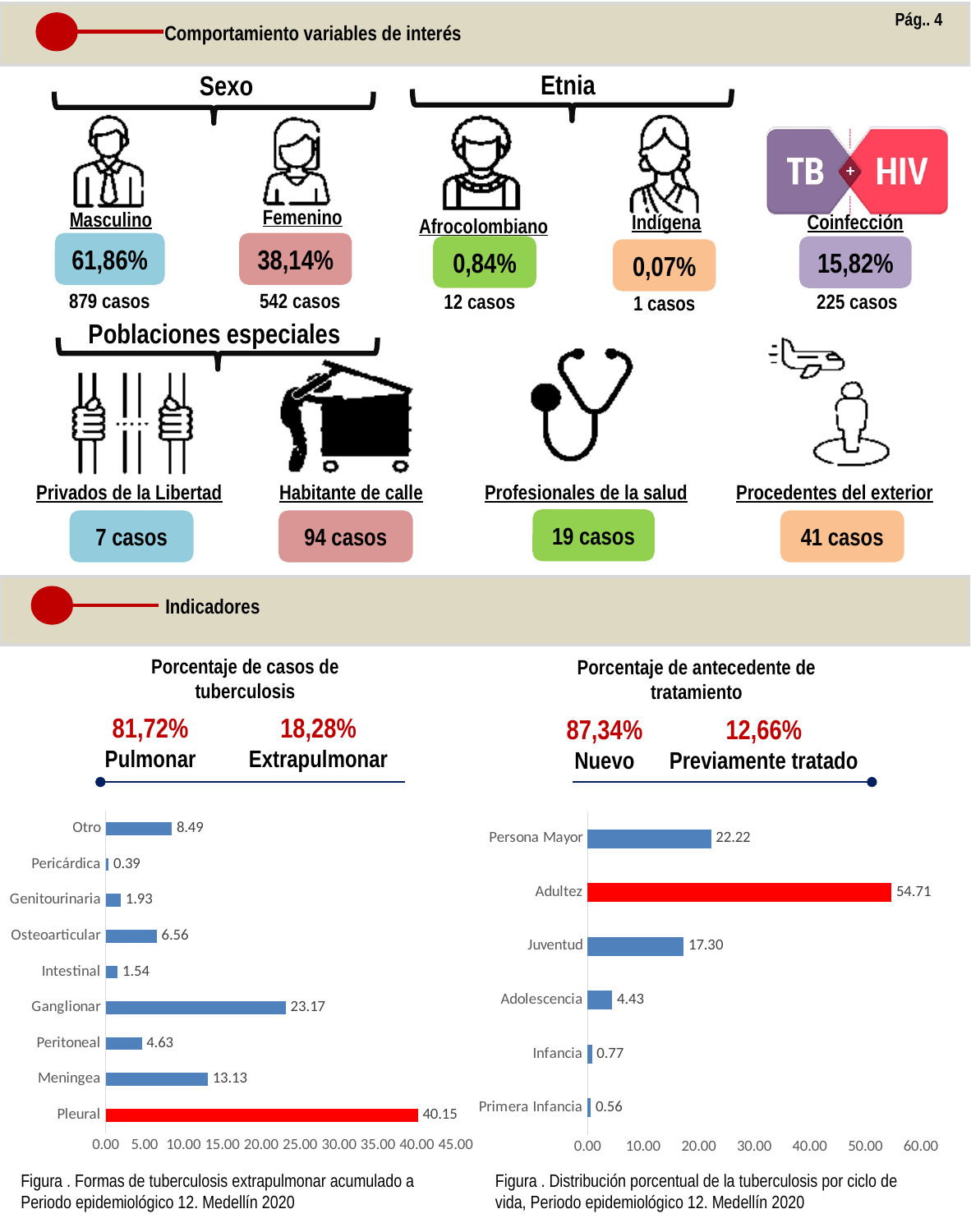
In the right chart (Distribución porcentual de la tuberculosis por ciclo de vida), which bar is coloured red? Adultez In the left chart (Formas de tuberculosis extrapulmonar), what is the value for Ganglionar? 23.17 What kind of chart is the right chart (Distribución porcentual de la tuberculosis por ciclo de vida)? Bar chart In the left chart (Formas de tuberculosis extrapulmonar), which category has the lowest value? Pericárdica In the left chart (Formas de tuberculosis extrapulmonar), how many categories are shown? 9 In the right chart (Distribución porcentual de la tuberculosis por ciclo de vida), what is the difference between Persona Mayor and Juventud? 4.92 In the left chart (Formas de tuberculosis extrapulmonar), which is larger, Otro or Osteoarticular? Otro In the right chart (Distribución porcentual de la tuberculosis por ciclo de vida), what is the value for Adultez? 54.71 In the left chart (Formas de tuberculosis extrapulmonar), what is the difference between the values for Pleural and Meningea? 27.02 In the left chart (Formas de tuberculosis extrapulmonar), which category has the highest value? Pleural In the right chart (Distribución porcentual de la tuberculosis por ciclo de vida), how many categories are shown? 6 In the right chart (Distribución porcentual de la tuberculosis por ciclo de vida), which category has the lowest value? Primera Infancia